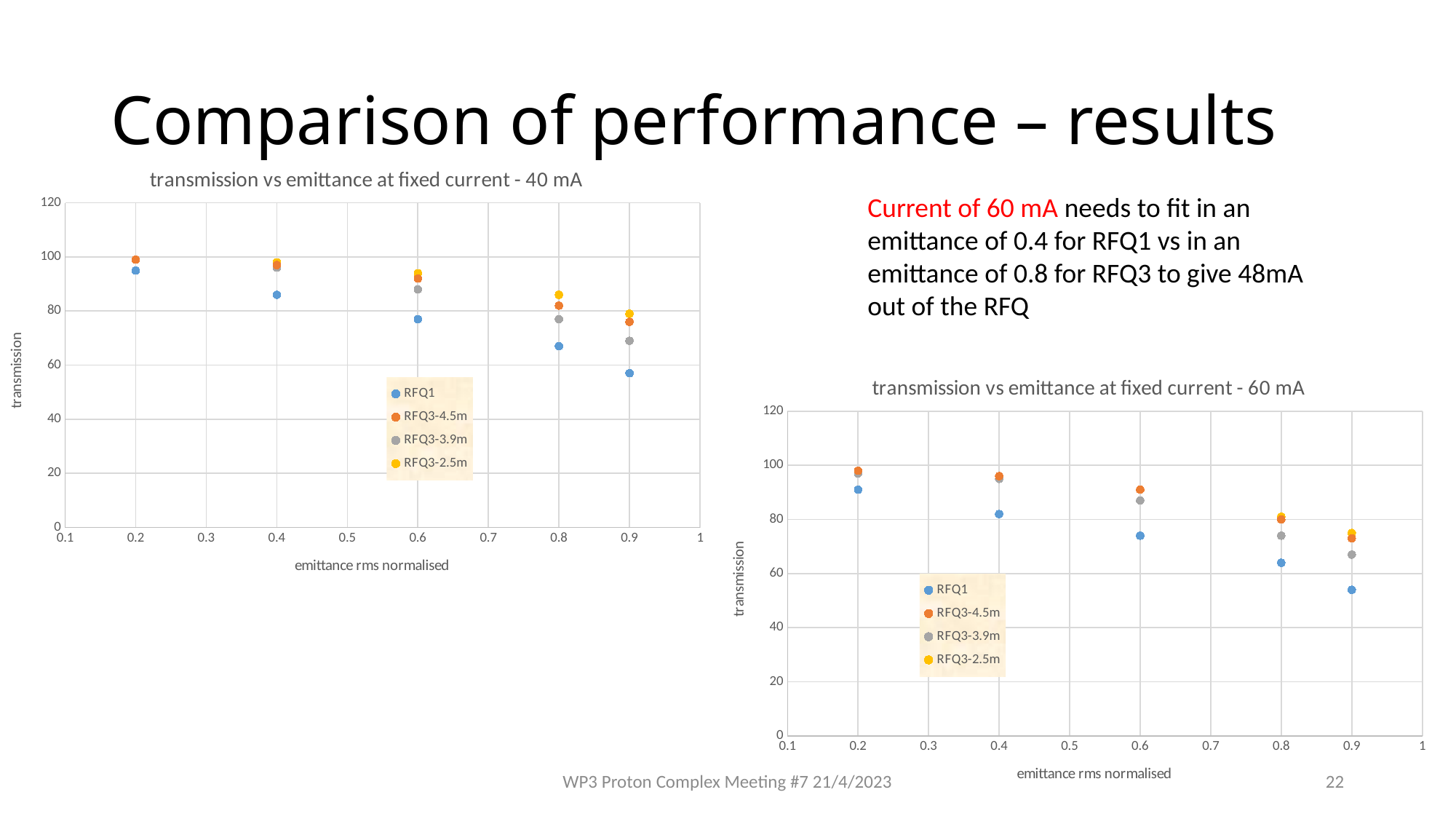
How many series does the legend of the 'transmission vs emittance at fixed current - 60 mA' chart list? 4 In the 'transmission vs emittance at fixed current - 40 mA' chart, is the RFQ1 transmission at emittance 0.4 greater or less than 80? greater In the 'transmission vs emittance at fixed current - 60 mA' chart, is the RFQ3-4.5m transmission at emittance 0.2 greater or less than 90? greater What kind of chart is the 'transmission vs emittance at fixed current - 40 mA' chart? scatter chart In the 'transmission vs emittance at fixed current - 60 mA' chart, which series has the lowest transmission at emittance 0.8? RFQ1 In the 'transmission vs emittance at fixed current - 40 mA' chart, at emittance 0.8, which is larger: the transmission for RFQ3-2.5m or for RFQ1? RFQ3-2.5m In the 'transmission vs emittance at fixed current - 40 mA' chart, does the RFQ1 transmission rise or fall as emittance increases? fall In the 'transmission vs emittance at fixed current - 40 mA' chart, is the RFQ1 transmission at emittance 0.9 greater or less than 60? less What is the x-axis label of the 'transmission vs emittance at fixed current - 60 mA' chart? emittance rms normalised In the 'transmission vs emittance at fixed current - 40 mA' chart, which series has the lowest transmission at emittance 0.9? RFQ1 In the 'transmission vs emittance at fixed current - 40 mA' chart, how many data points are plotted for the RFQ1 series? 5